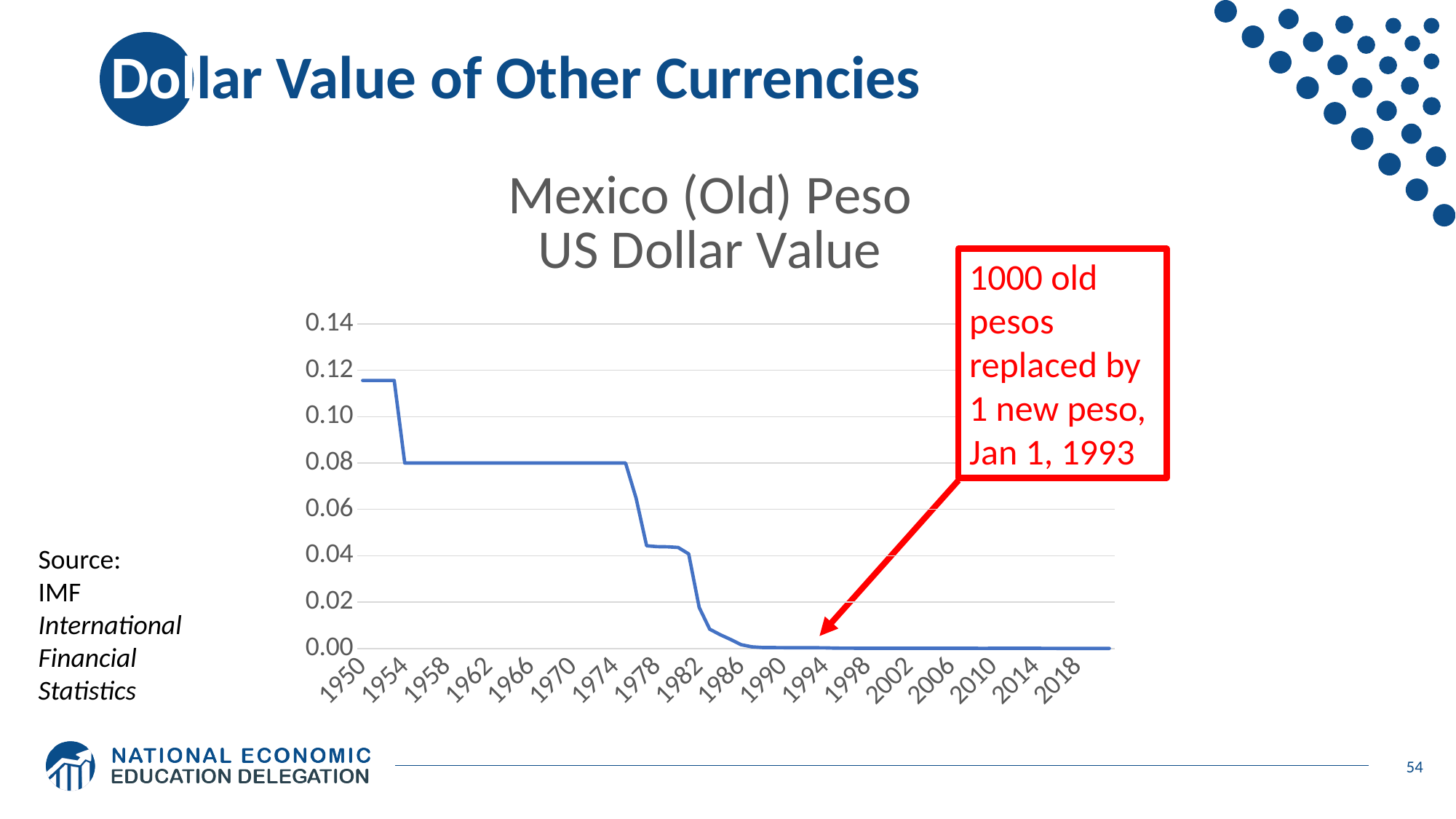
Which year shown has the highest US dollar value for the old peso? 1950 Is the value for 1950 greater or less than 0.10? greater Is the value for 1970 greater or less than 0.06? greater Is the value for 1978 greater or less than 0.06? less What is the title of the chart? Mexico (Old) Peso US Dollar Value What is the US dollar value of the old peso in 1966? 0.08 Which is larger, the value in 1962 or the value in 1982? 1962 Overall, does the US dollar value of the Mexican old peso rise or fall from 1950 to 2018? fall What kind of chart is shown on the slide? line chart How many year labels are shown on the x axis? 18 According to the red annotation box, how many old pesos were replaced by 1 new peso on Jan 1, 1993? 1000